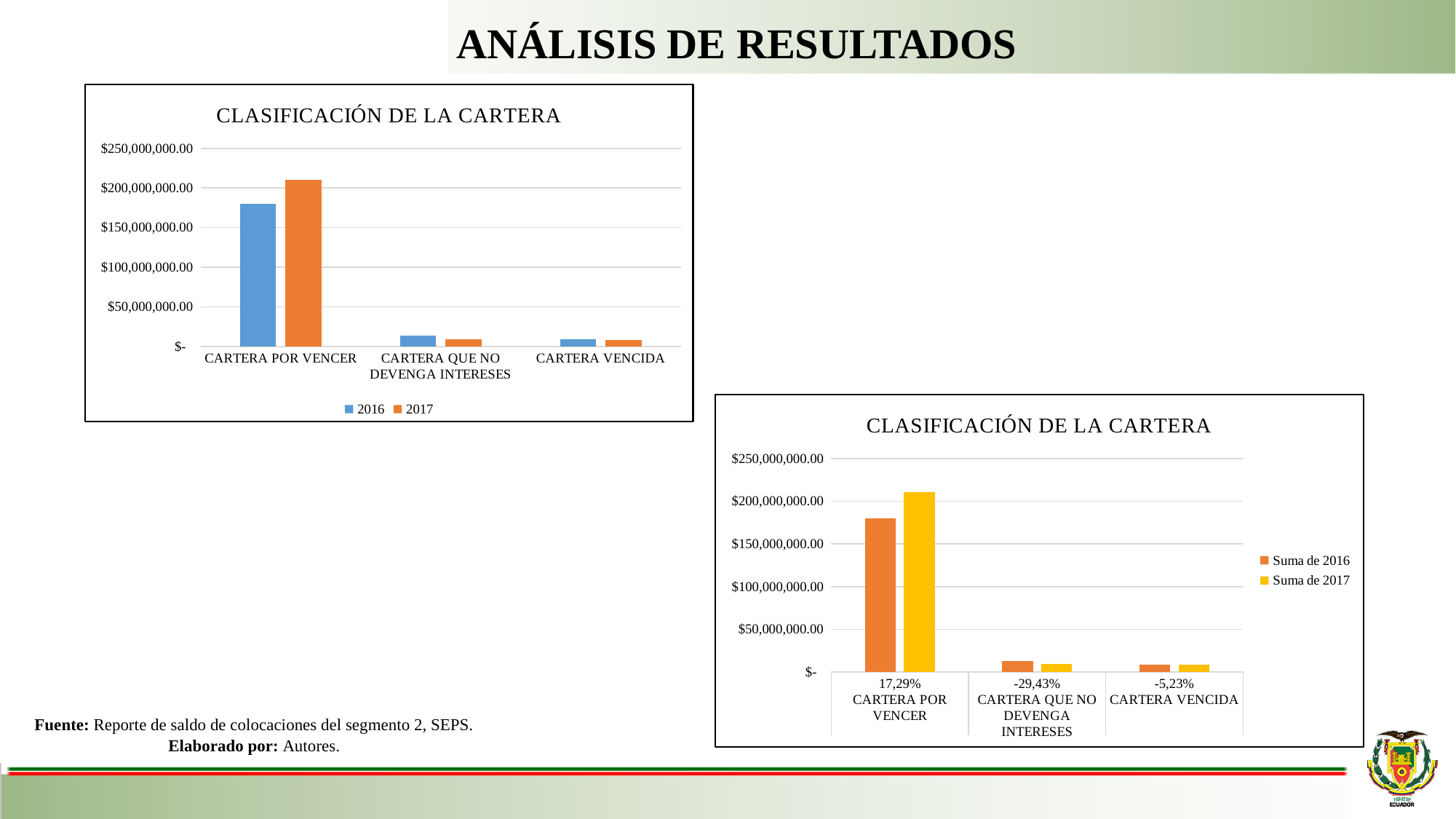
In the top-left chart, for CARTERA POR VENCER, which is larger: the 2016 value or the 2017 value? 2017 In the bottom-right chart, what percentage is printed under CARTERA POR VENCER? 17,29% How many series does the legend of the top-left chart list? 2 How many categories are shown on the x axis of the top-left chart? 3 In the top-left chart, which category has the highest values? CARTERA POR VENCER What type of chart is the top-left chart? bar chart In the top-left chart, is the 2017 value for CARTERA POR VENCER greater or less than $200,000,000.00? greater In the bottom-right chart, for CARTERA QUE NO DEVENGA INTERESES, which is larger: Suma de 2016 or Suma de 2017? Suma de 2016 In the bottom-right chart, what percentage is printed under CARTERA QUE NO DEVENGA INTERESES? -29,43% What are the legend entries of the bottom-right chart? Suma de 2016, Suma de 2017 In the top-left chart, is the 2016 value for CARTERA POR VENCER greater or less than $200,000,000.00? less In the top-left chart, which category has the lowest values? CARTERA VENCIDA